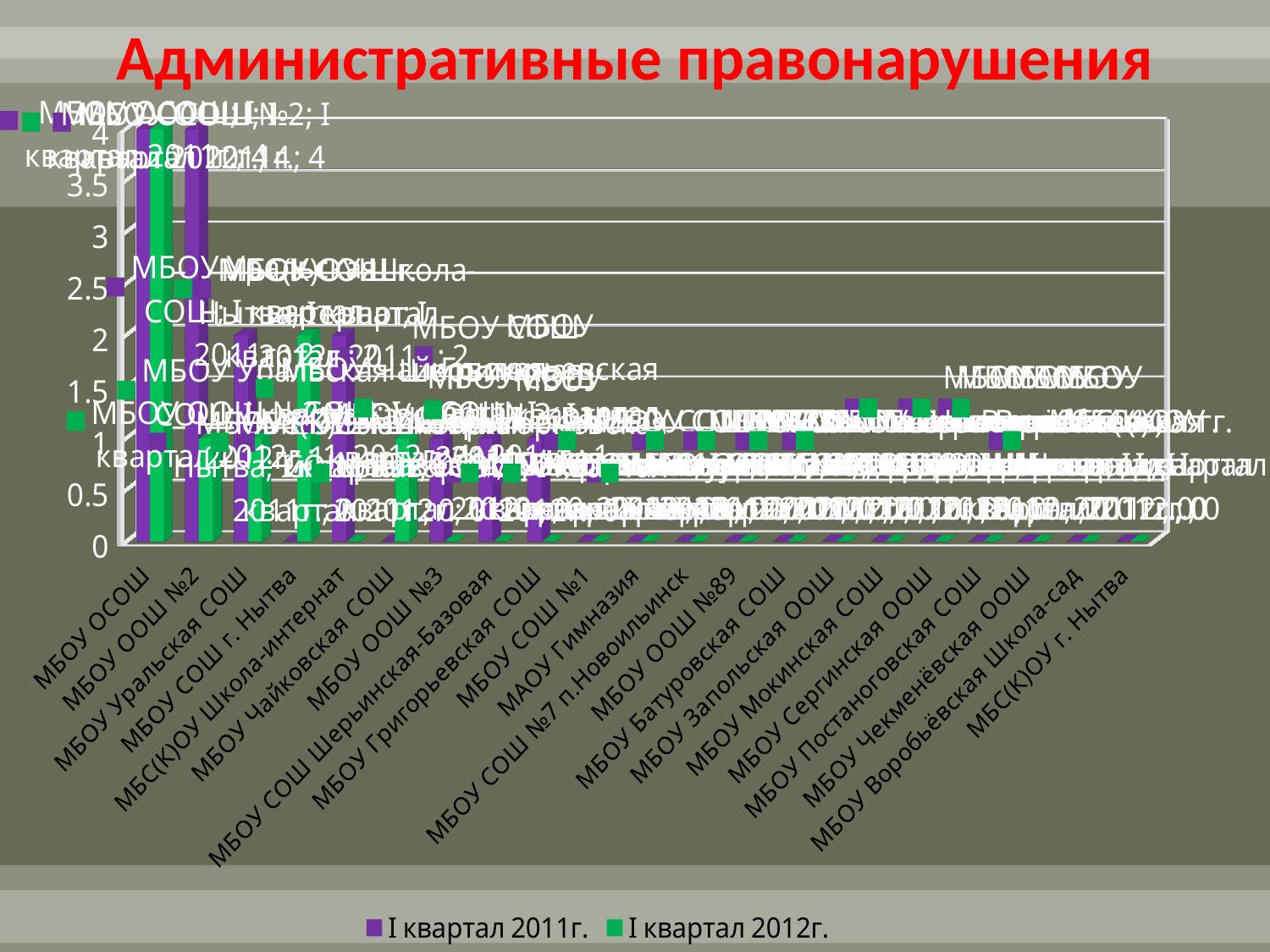
What are the two series named in the legend? I квартал 2011г. and I квартал 2012г. Is the value for МБОУ ОСОШ in I квартал 2011г. greater or less than 3? greater What is the title of the chart? Административные правонарушения What kind of chart is shown on the slide? bar chart Which has the larger value for I квартал 2011г.: МБОУ ОСОШ or МБОУ Чайковская СОШ? МБОУ ОСОШ How many school categories are shown on the x axis? 21 Which has the larger value for I квартал 2012г.: МБОУ ОСОШ or МБОУ ООШ №2? МБОУ ОСОШ Is the value for МБОУ Уральская СОШ in I квартал 2012г. greater or less than 2? less Is the value for МБОУ ООШ №2 in I квартал 2011г. greater or less than 3? greater How many series does the legend list? 2